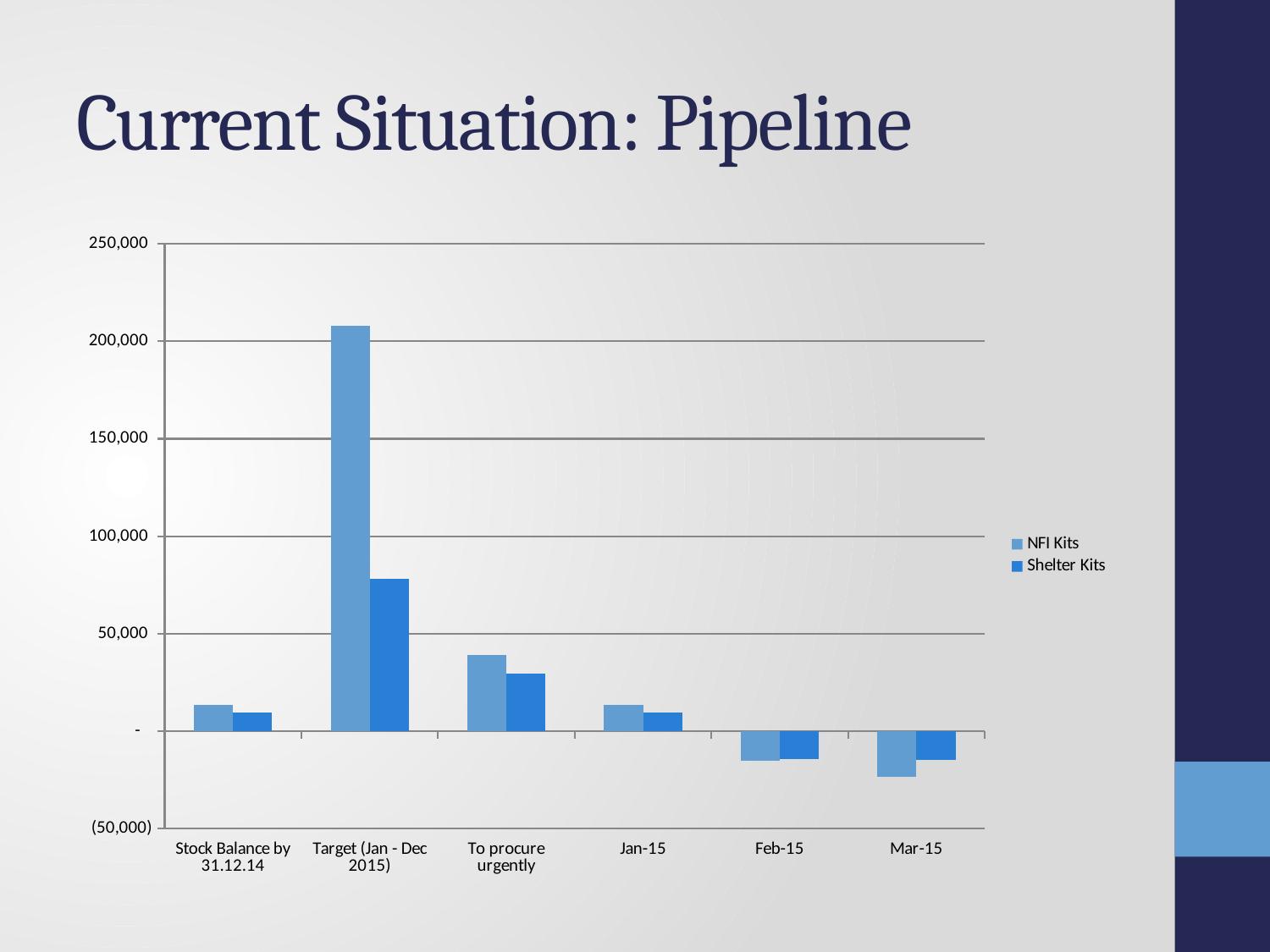
Is the NFI Kits value for Feb-15 positive or negative? negative Which category has the highest value for NFI Kits? Target (Jan - Dec 2015) How many categories are shown along the x axis of the chart? 6 Which category has the highest value for Shelter Kits? Target (Jan - Dec 2015) What kind of chart is shown on the slide? Bar chart For Target (Jan - Dec 2015), which is larger: NFI Kits or Shelter Kits? NFI Kits Is the NFI Kits value for To procure urgently greater or less than 50,000? less Which series are listed in the chart's legend? NFI Kits and Shelter Kits Is the NFI Kits value for Target (Jan - Dec 2015) greater or less than 200,000? greater How many series does the chart's legend list? 2 Which category has the lowest value for NFI Kits? Mar-15